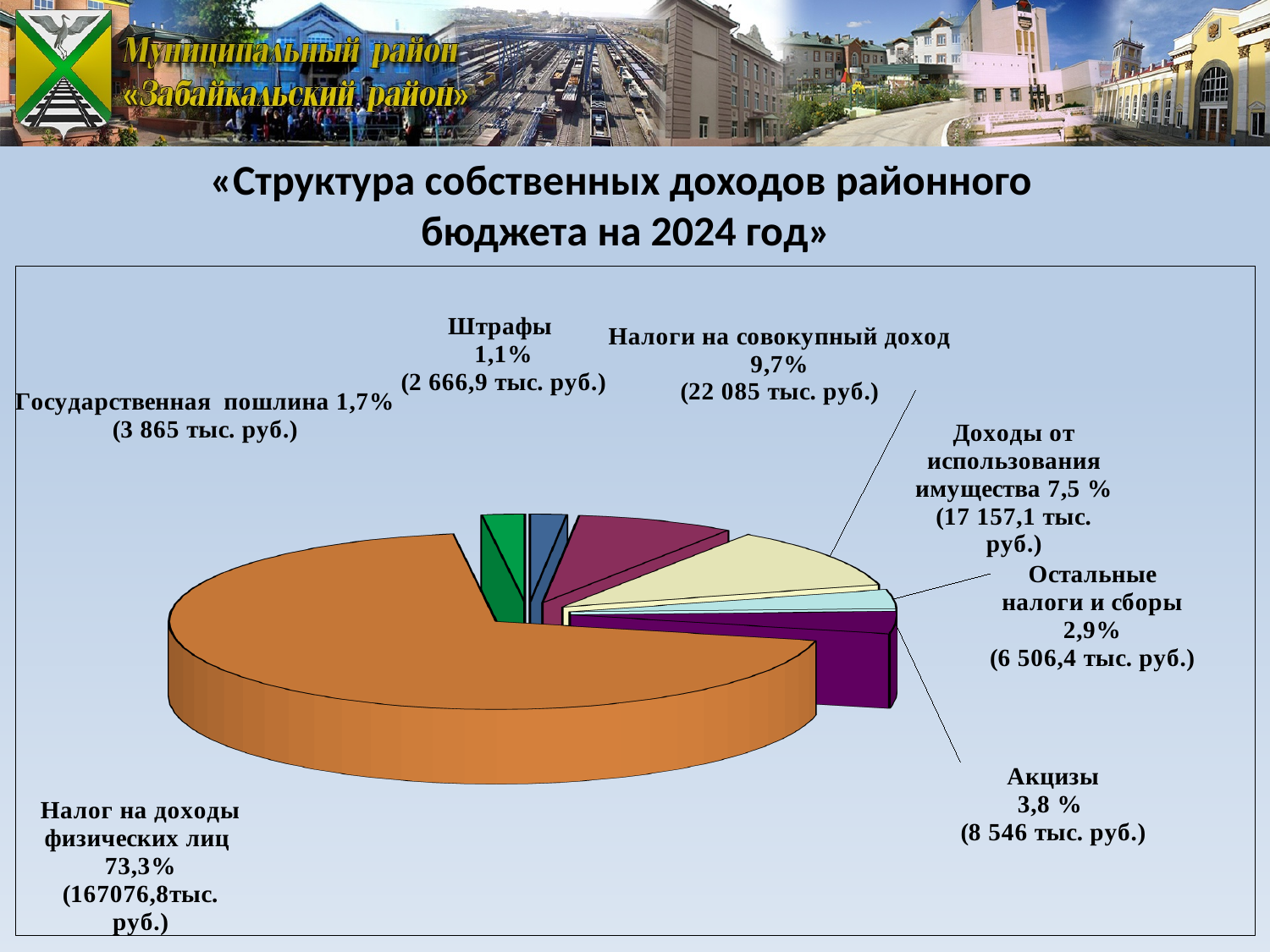
What is the value in thousand rubles for «Акцизы»? 8 546 тыс. руб. Which is larger: the share for «Остальные налоги и сборы» or the share for «Государственная пошлина»? Остальные налоги и сборы What share of the pie does «Доходы от использования имущества» have? 7,5 % What is the value in thousand rubles for «Штрафы»? 2 666,9 тыс. руб. What share of the pie does «Налог на доходы физических лиц» have? 73,3% What is the difference in percentage points between the share for «Налоги на совокупный доход» and the share for «Доходы от использования имущества»? 2,2 What is the value in thousand rubles for «Налоги на совокупный доход»? 22 085 тыс. руб. What is the title of the chart on the slide? «Структура собственных доходов районного бюджета на 2024 год» How many categories (slices) does the pie chart show? 7 Which category has the largest share of the pie? Налог на доходы физических лиц Which category has the smallest share of the pie? Штрафы What kind of chart is shown on the slide? pie chart